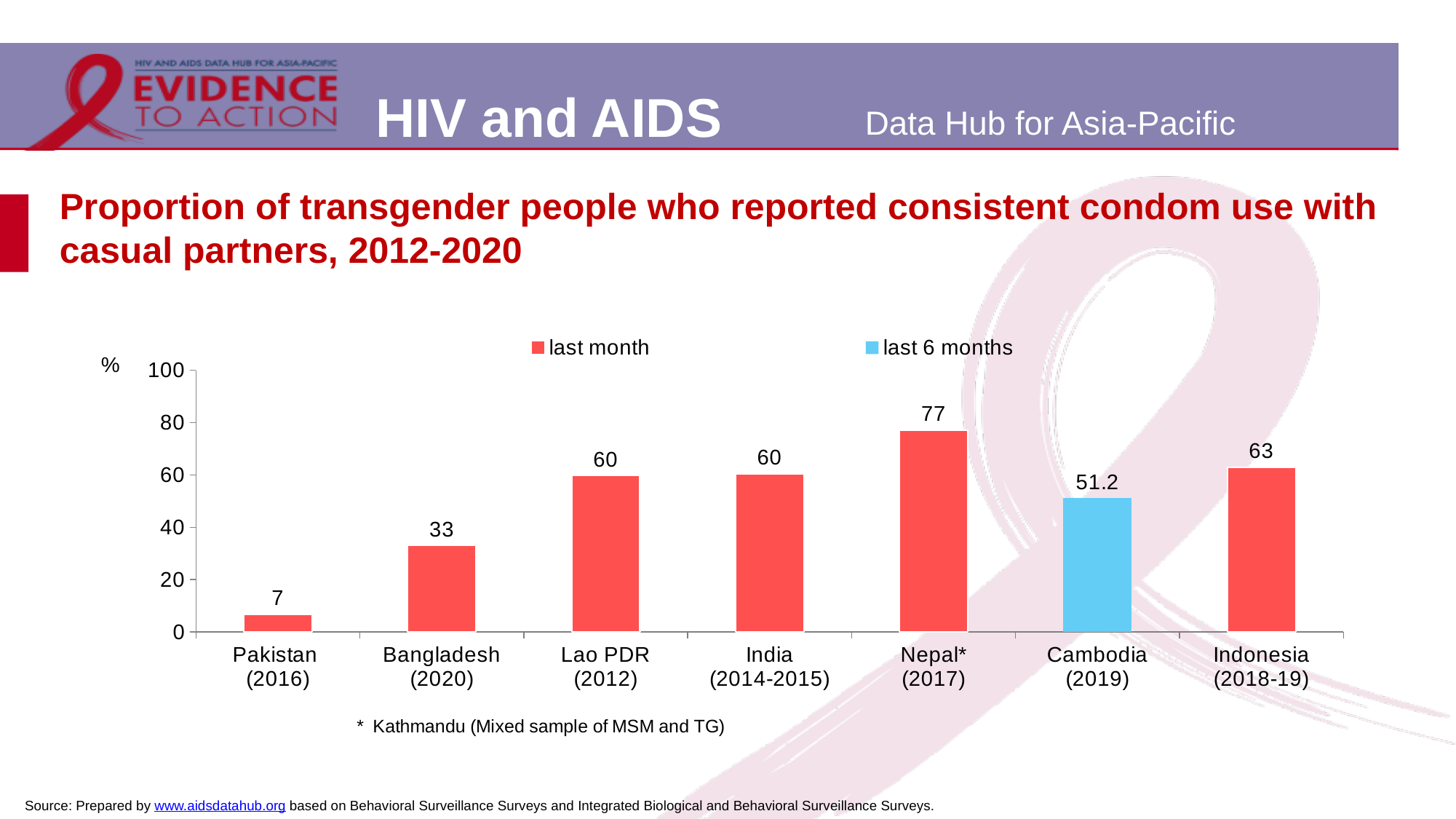
Which country has the highest value? Nepal* (2017) What kind of chart is shown on the slide? bar chart Is the value for Bangladesh (2020) greater or less than 40? less Which is larger, the value for Indonesia (2018-19) or the value for Cambodia (2019)? Indonesia (2018-19) What is the value for Pakistan (2016)? 7 What is the value for Indonesia (2018-19)? 63 What is the difference between the values for Nepal* (2017) and Bangladesh (2020)? 44 Which series does the Cambodia (2019) bar belong to, according to the legend? last 6 months How many series does the legend list? 2 Which country has the lowest value? Pakistan (2016) How many countries are shown on the chart? 7 What is the value for Cambodia (2019)? 51.2